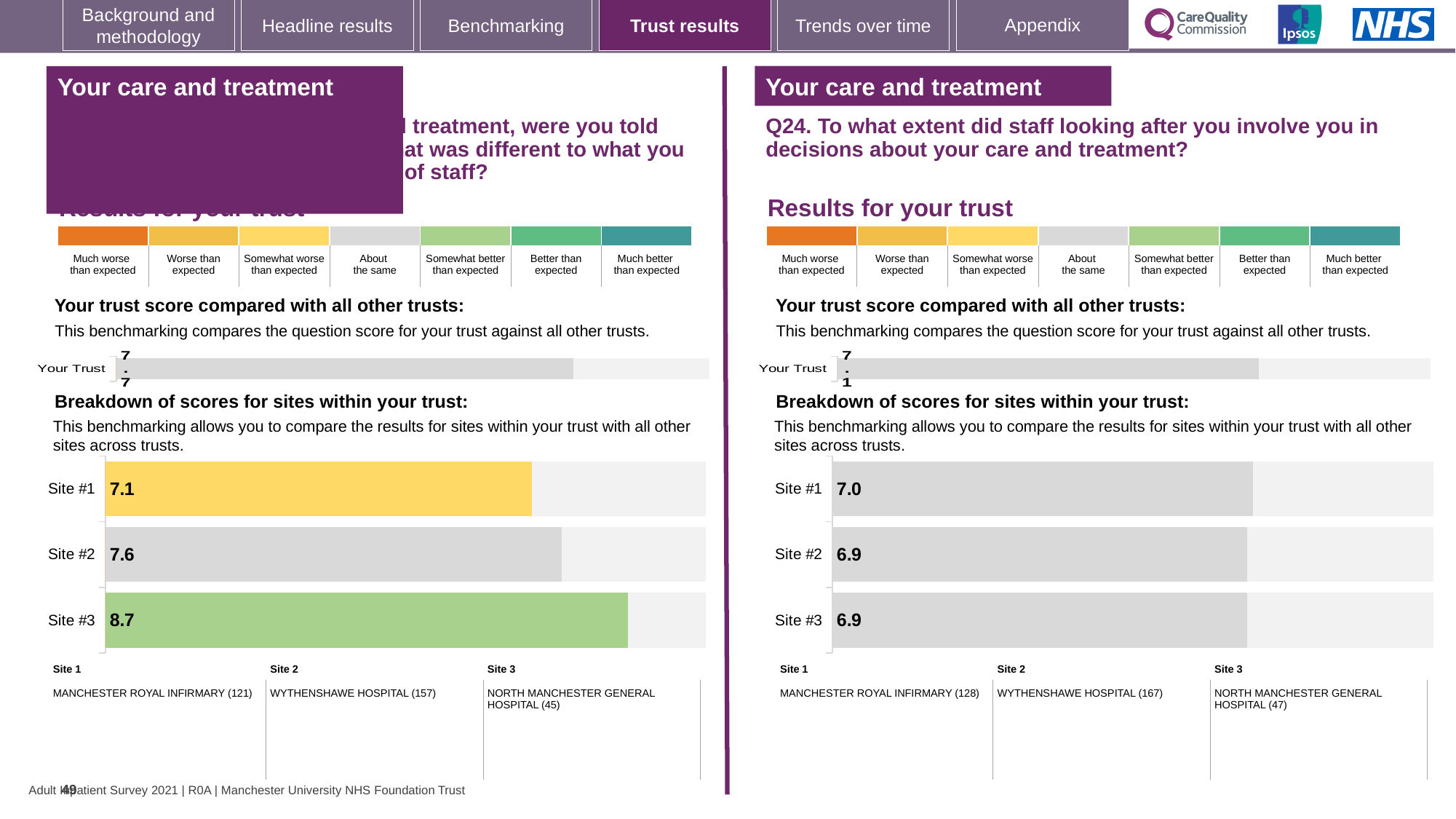
What type of chart is used for the site breakdown on the left-hand side of the slide? Bar chart In the Q24 site breakdown chart on the right, what is the score for Site #2? 6.9 In the left-hand site breakdown chart, what is the score for Site #1? 7.1 In the left-hand site breakdown chart, which site has the lowest score? Site #1 In the Q24 'Your trust score compared with all other trusts' chart on the right, what is the score for Your Trust? 7.1 In the left-hand site breakdown chart, which is larger: the score for Site #2 or the score for Site #1? Site #2 In the left-hand site breakdown chart, what is the difference between the scores for Site #3 and Site #1? 1.6 In the left-hand site breakdown chart, what is the score for Site #3? 8.7 In the Q24 site breakdown chart on the right, what is the score for Site #1? 7.0 In the left-hand 'Your trust score compared with all other trusts' chart, what is the score for Your Trust? 7.7 In the left-hand site breakdown chart, which site has the highest score? Site #3 In the Q24 site breakdown chart on the right, how many sites are shown? 3